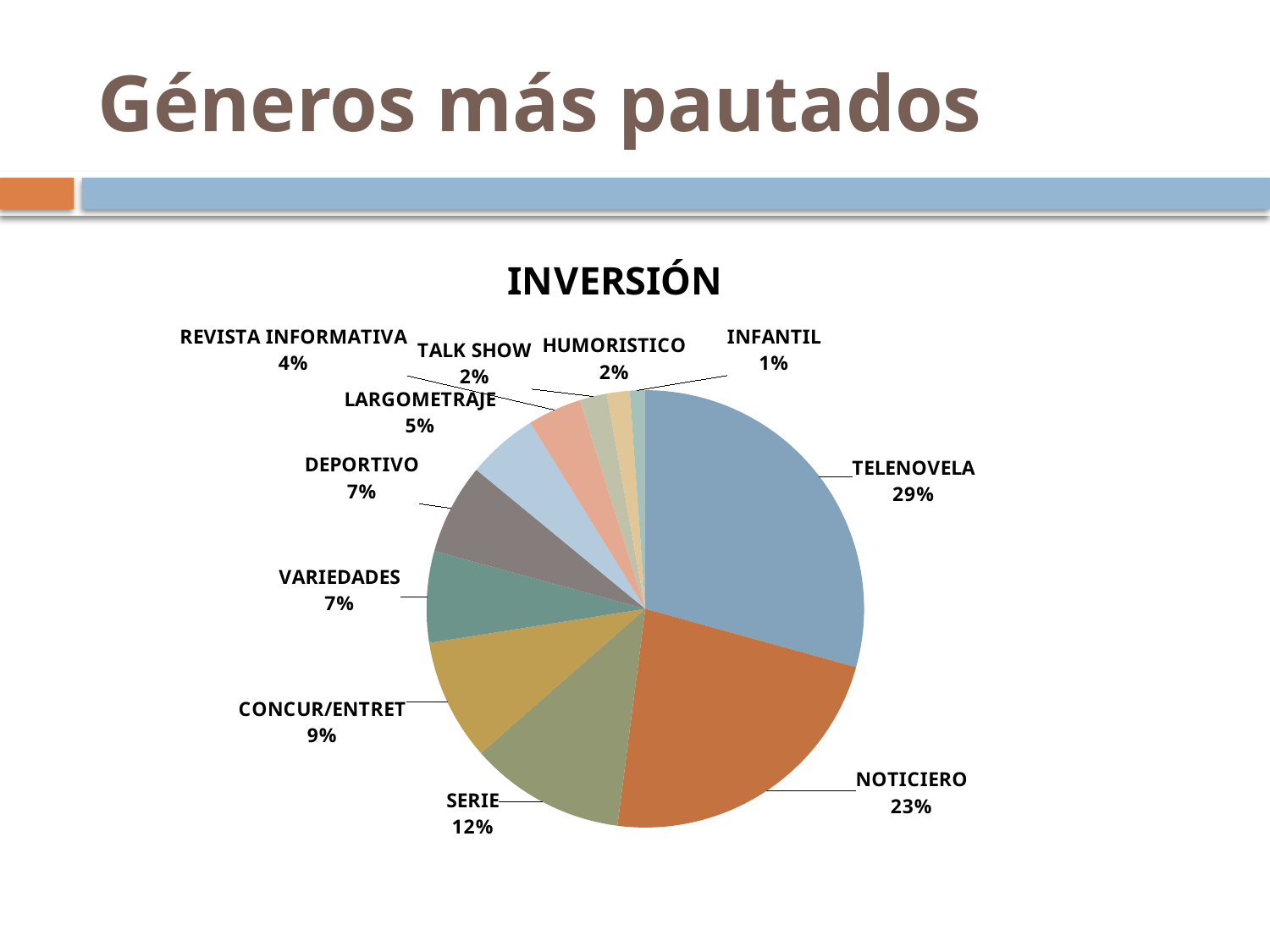
How many categories are shown in the pie chart? 11 What is the difference between the REVISTA INFORMATIVA and TALK SHOW shares? 2% What share of the pie does TELENOVELA have? 29% Which category has the smallest slice of the pie? INFANTIL Which is larger, the share for SERIE or the share for CONCUR/ENTRET? SERIE What is the value shown for SERIE? 12% What is the difference between the TELENOVELA and NOTICIERO shares? 6% Which category has the largest slice of the pie? TELENOVELA What is the value shown for NOTICIERO? 23% What is the value shown for LARGOMETRAJE? 5% What is the title of the chart? INVERSIÓN What kind of chart is shown on the slide? pie chart